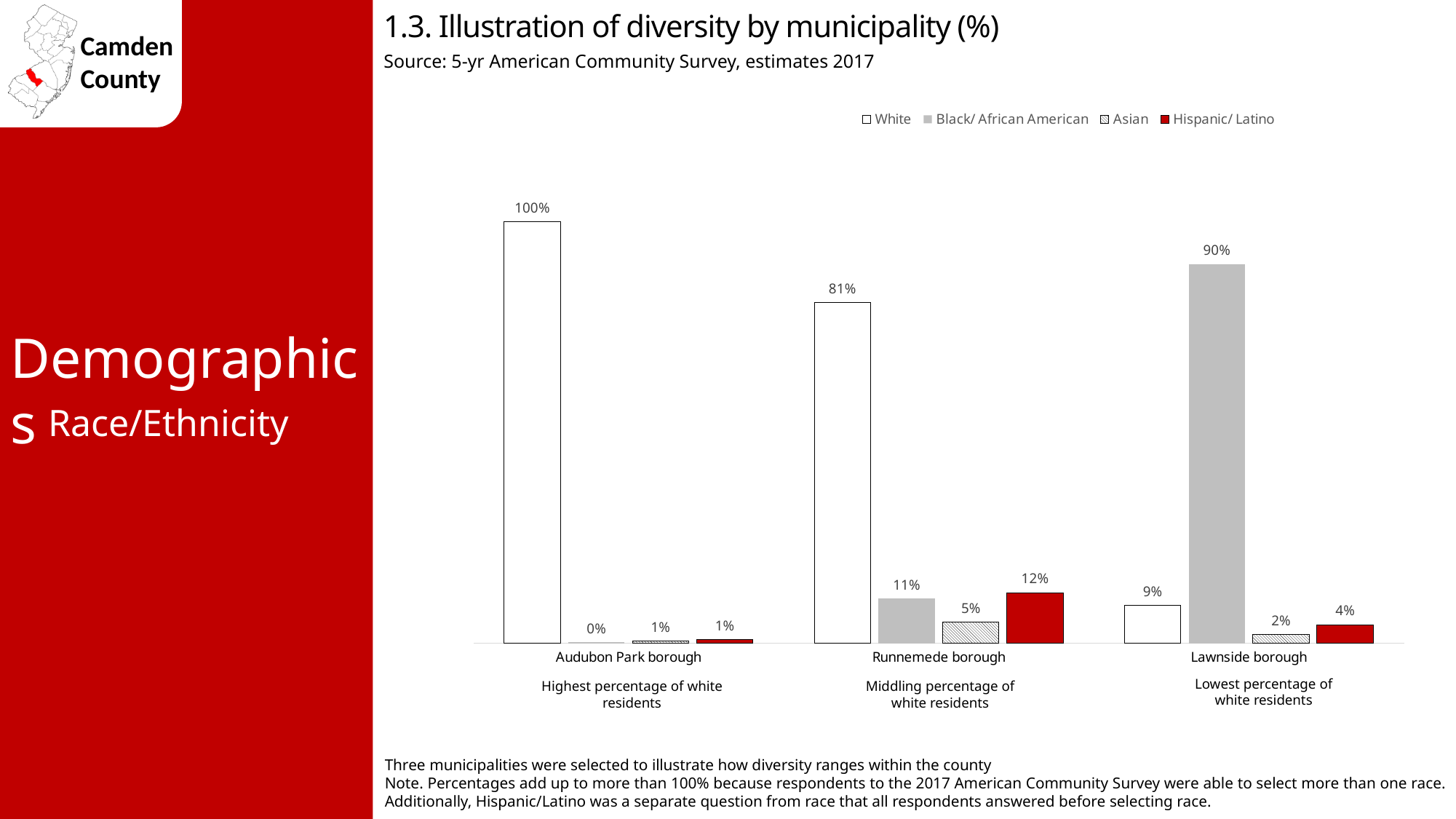
How many municipalities are shown on the chart? 3 What is the difference between the White percentage for Audubon Park borough and Runnemede borough? 19% Which municipality has the lowest White percentage? Lawnside borough What is the Hispanic/ Latino percentage for Runnemede borough? 12% Which is larger: the Hispanic/ Latino percentage for Runnemede borough or for Lawnside borough? Runnemede borough What is the White percentage for Audubon Park borough? 100% What kind of chart is shown on the slide? Bar chart How many series does the legend list? 4 Which municipality has the highest White percentage? Audubon Park borough What is the Asian percentage for Lawnside borough? 2% What is the Black/ African American percentage for Lawnside borough? 90% Which series is shown in red on the chart? Hispanic/ Latino